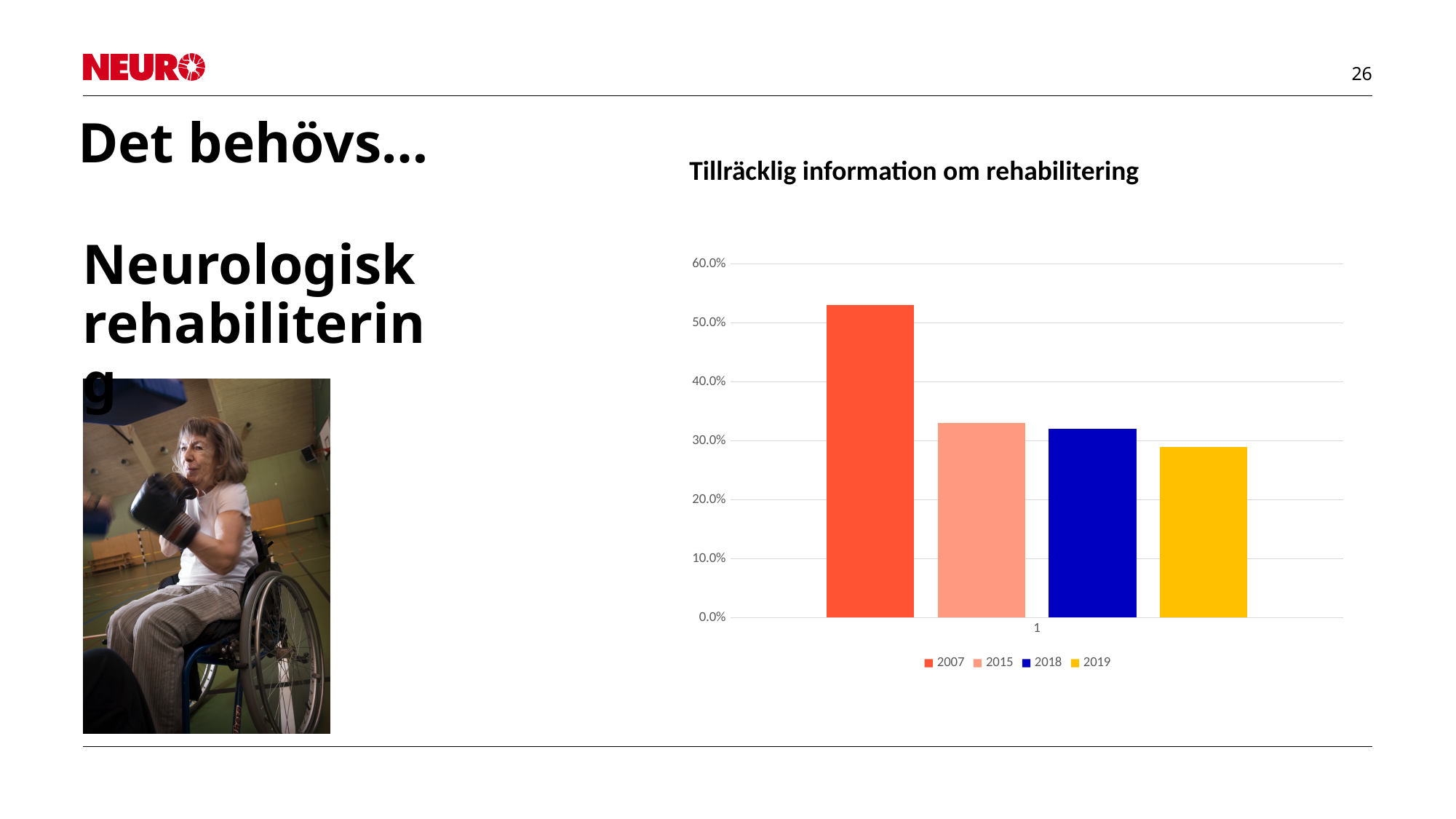
Which year has the highest value in the chart? 2007 Which year has the lowest value in the chart? 2019 Which is larger, the value for 2007 or the value for 2019? 2007 Is the value for 2007 greater or less than 50.0%? greater What kind of chart is shown on the slide? bar chart How many series does the chart legend list? 4 What is the title of the chart? Tillräcklig information om rehabilitering How many bars are plotted in the chart? 4 Do the values rise or fall from 2007 to 2019? fall Is the value for 2015 greater or less than 30.0%? greater Which colour represents the 2019 series in the chart? yellow